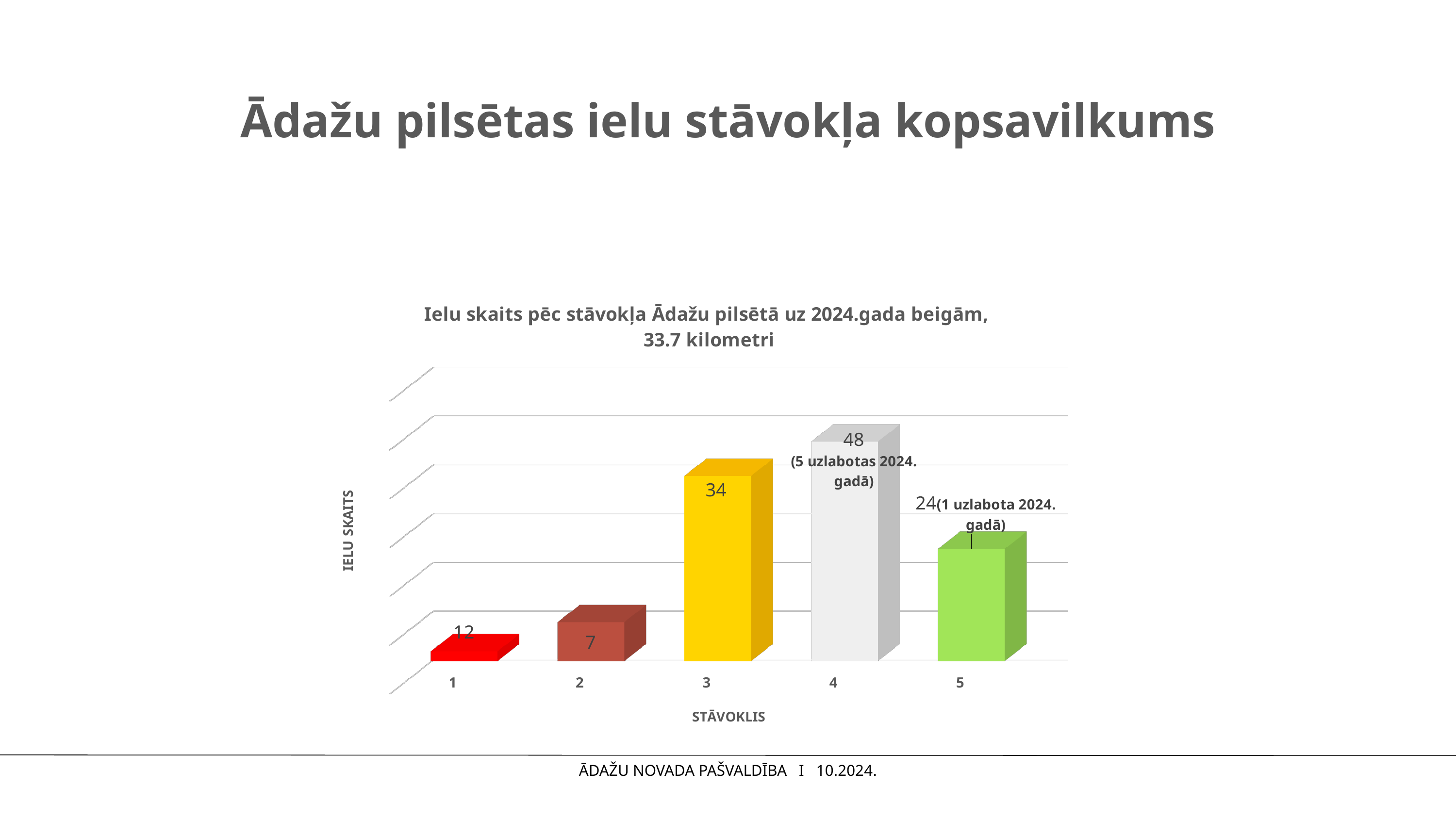
What is the value for category 1? 12 What is the value for category 3? 34 What is the value for category 5? 24 What is the difference between the values for category 1 and category 2? 5 Which is larger, the value for category 5 or the value for category 1? category 5 How many categories are shown on the x axis? 5 What is the title of the chart? Ielu skaits pēc stāvokļa Ādažu pilsētā uz 2024.gada beigām, 33.7 kilometri What is the label of the x axis? STĀVOKLIS What is the difference between the values for category 4 and category 3? 14 Which category has the highest value? 4 What kind of chart is shown on the slide? bar chart